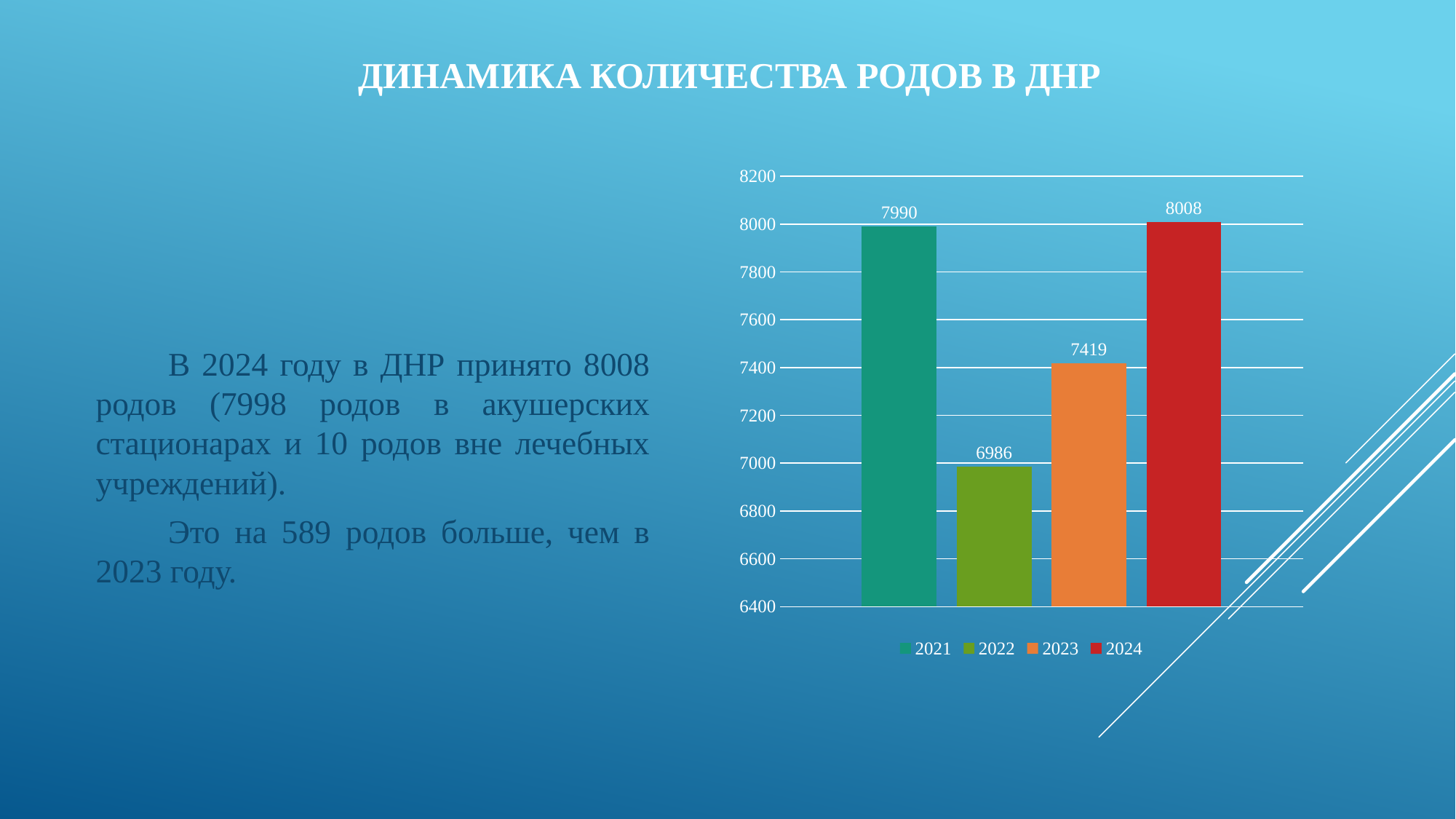
Which year has the highest value? 2024 What is the difference between the values for 2021 and 2022? 1004 Which is larger, the value for 2021 or the value for 2023? 2021 What is the value for 2022? 6986 Which year has the lowest value? 2022 What kind of chart is shown on the slide? bar chart What is the value for 2023? 7419 Is the value for 2022 greater or less than 7000? less What is the difference between the values for 2024 and 2023? 589 How many bars are shown in the chart? 4 What is the value for 2024? 8008 What is the value for 2021? 7990